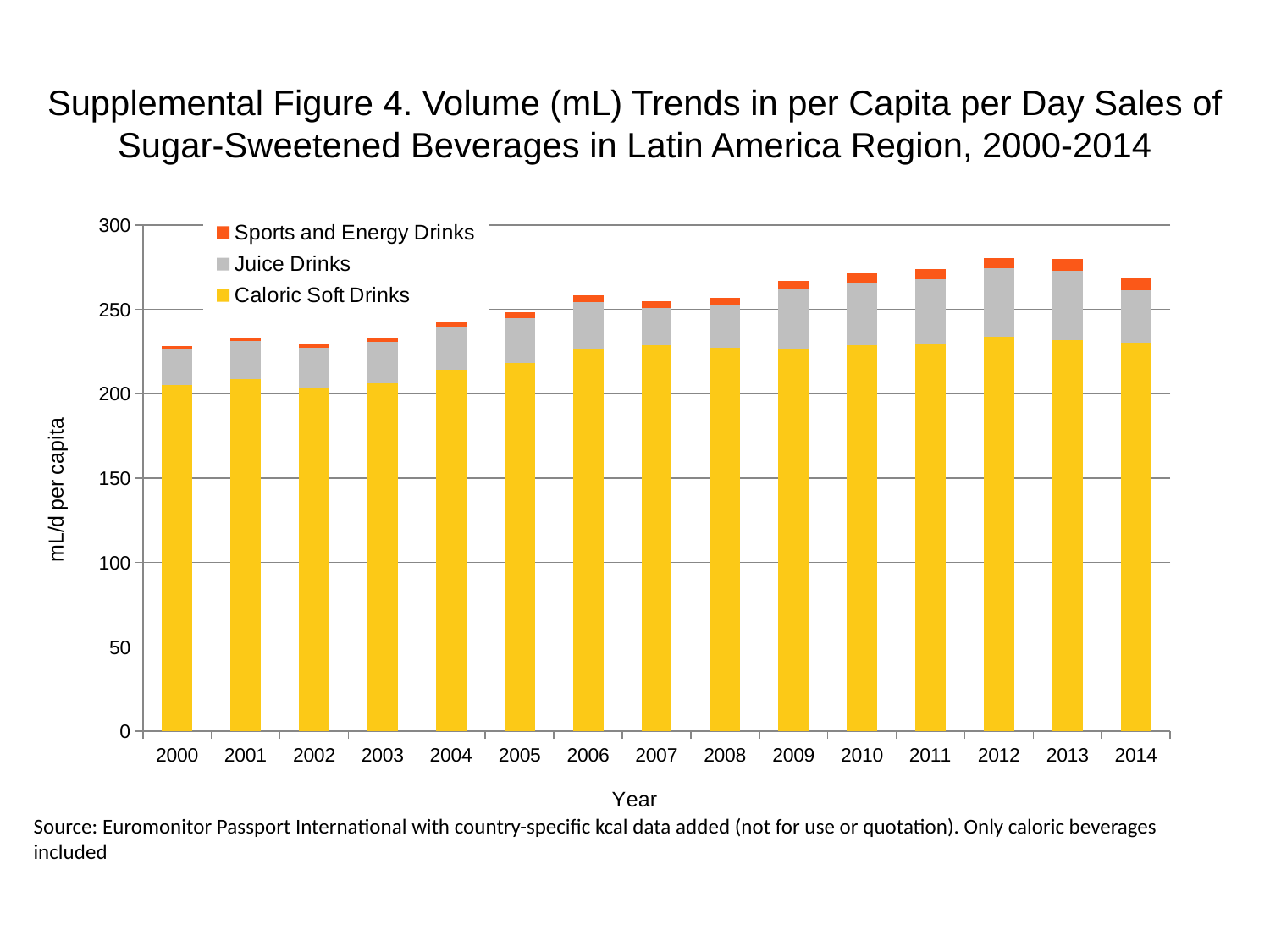
What kind of chart is shown on the slide? Stacked bar chart Is the Caloric Soft Drinks value for 2014 greater or less than 250? less Which year has the larger Caloric Soft Drinks value, 2000 or 2007? 2007 Which year has the larger total bar, 2000 or 2012? 2012 Which series is shown in orange in the legend? Sports and Energy Drinks How many series does the legend list? 3 How many years are shown along the x axis? 15 Do the total bar heights generally rise or fall from 2000 to 2012? rise Is the total bar height for 2000 greater or less than 250? less What is the label on the y axis? mL/d per capita Is the total bar height for 2012 greater or less than 250? greater